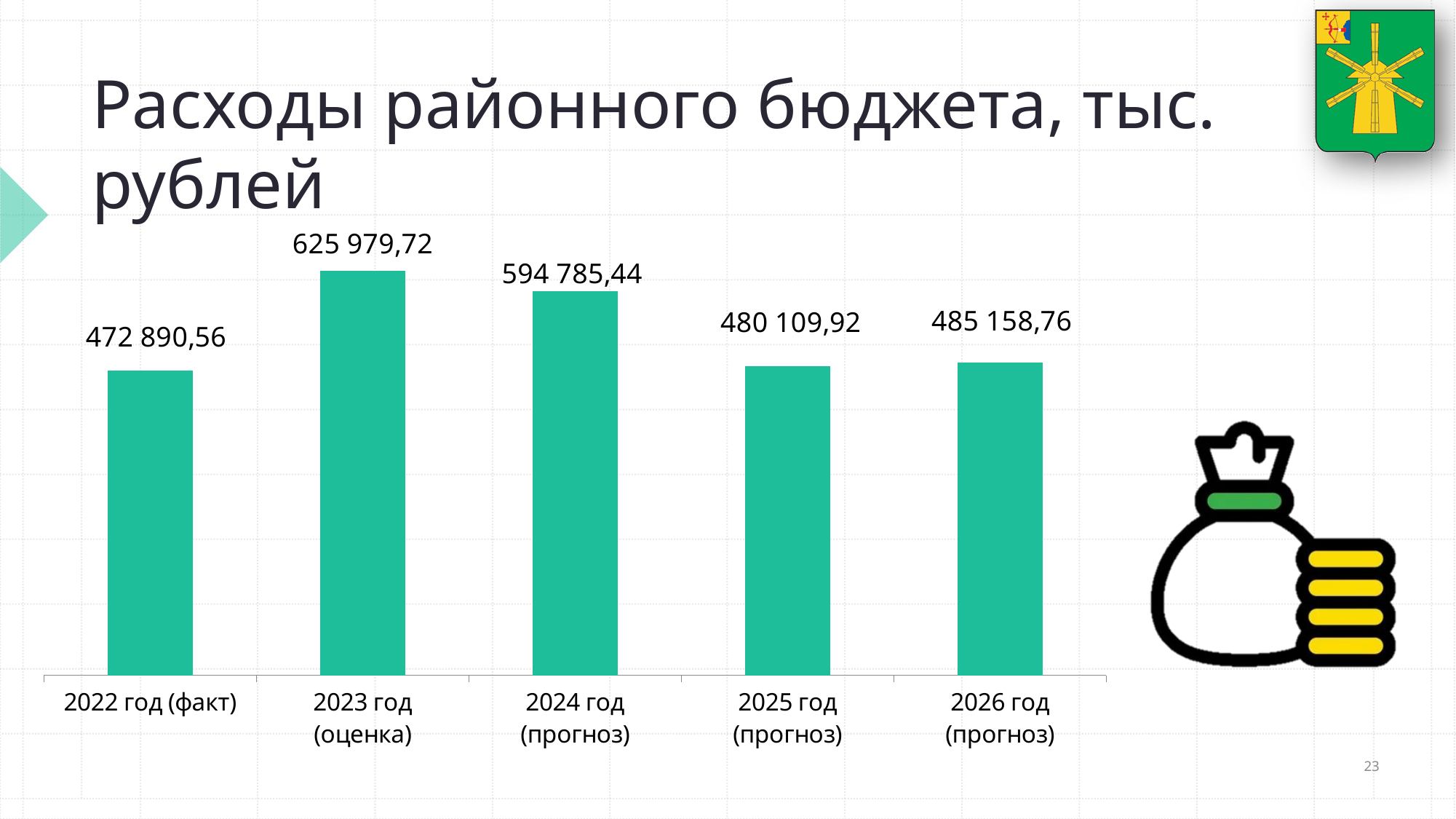
What is the value for 2022 год (факт)? 472 890,56 What is the title of the slide? Расходы районного бюджета, тыс. рублей How many bars are shown in the chart? 5 What kind of chart is shown on the slide? Bar chart Which year has the lowest value? 2022 год (факт) Which is larger, the value for 2025 год (прогноз) or 2026 год (прогноз)? 2026 год (прогноз) What is the value for 2024 год (прогноз)? 594 785,44 Which year has the highest value? 2023 год (оценка) What is the value for 2026 год (прогноз)? 485 158,76 What is the value for 2023 год (оценка)? 625 979,72 What is the value for 2025 год (прогноз)? 480 109,92 What is the difference between the values for 2023 год (оценка) and 2024 год (прогноз)? 31 194,28